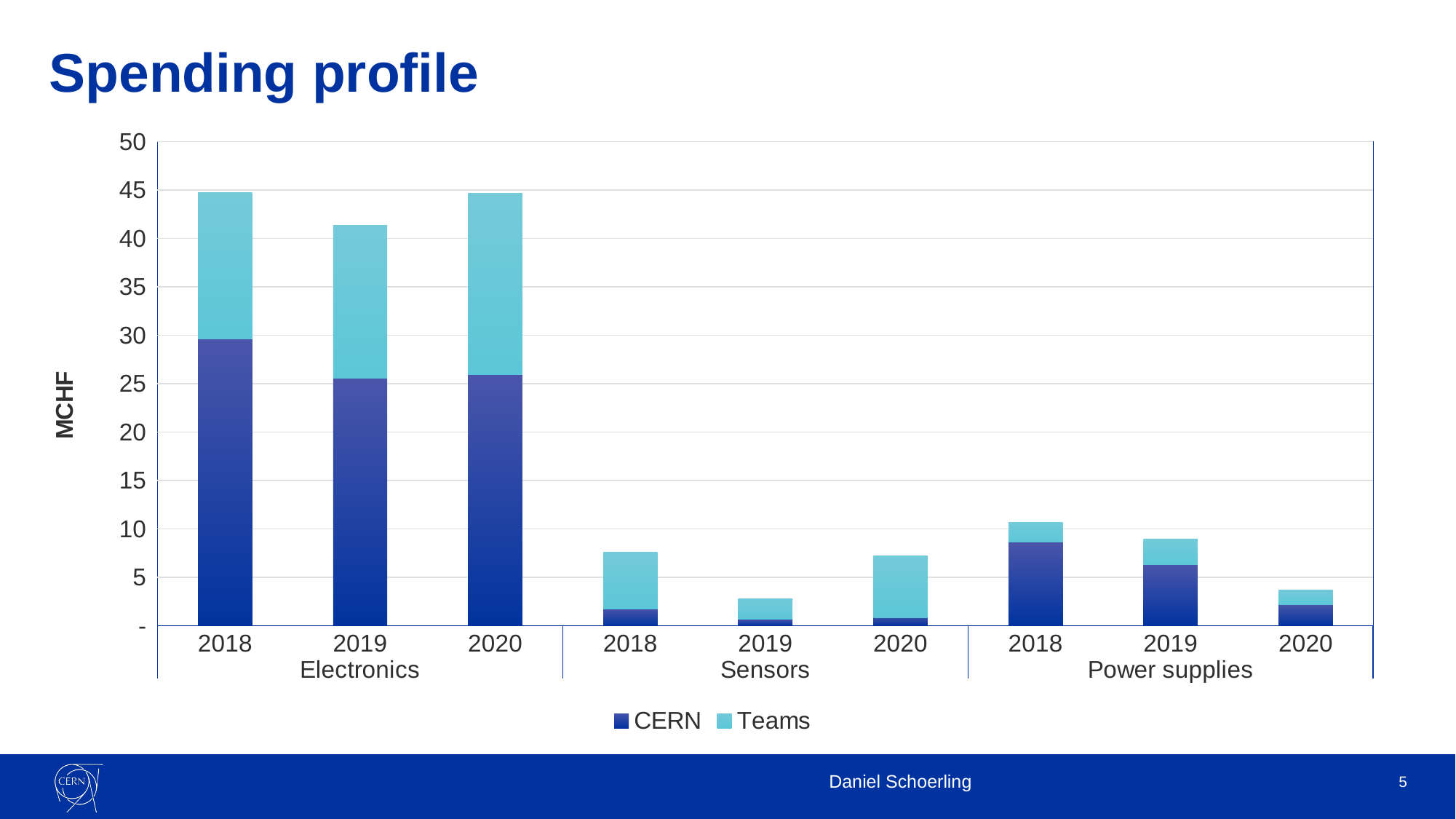
Is the total value for Electronics 2018 greater or less than 40? greater How many bars are plotted in the chart? 9 Which has the larger total bar, Sensors 2018 or Sensors 2019? Sensors 2018 What kind of chart is shown on the slide? Stacked bar chart Is the total value for Power supplies 2018 greater or less than 5? greater What is the label on the vertical axis? MCHF Is the CERN value for Electronics 2018 greater or less than 25? greater Do the total values for Power supplies rise or fall from 2018 to 2020? fall Within the Electronics group, which year has the lowest total bar? 2019 Which series are listed in the legend? CERN and Teams How many series does the legend list? 2